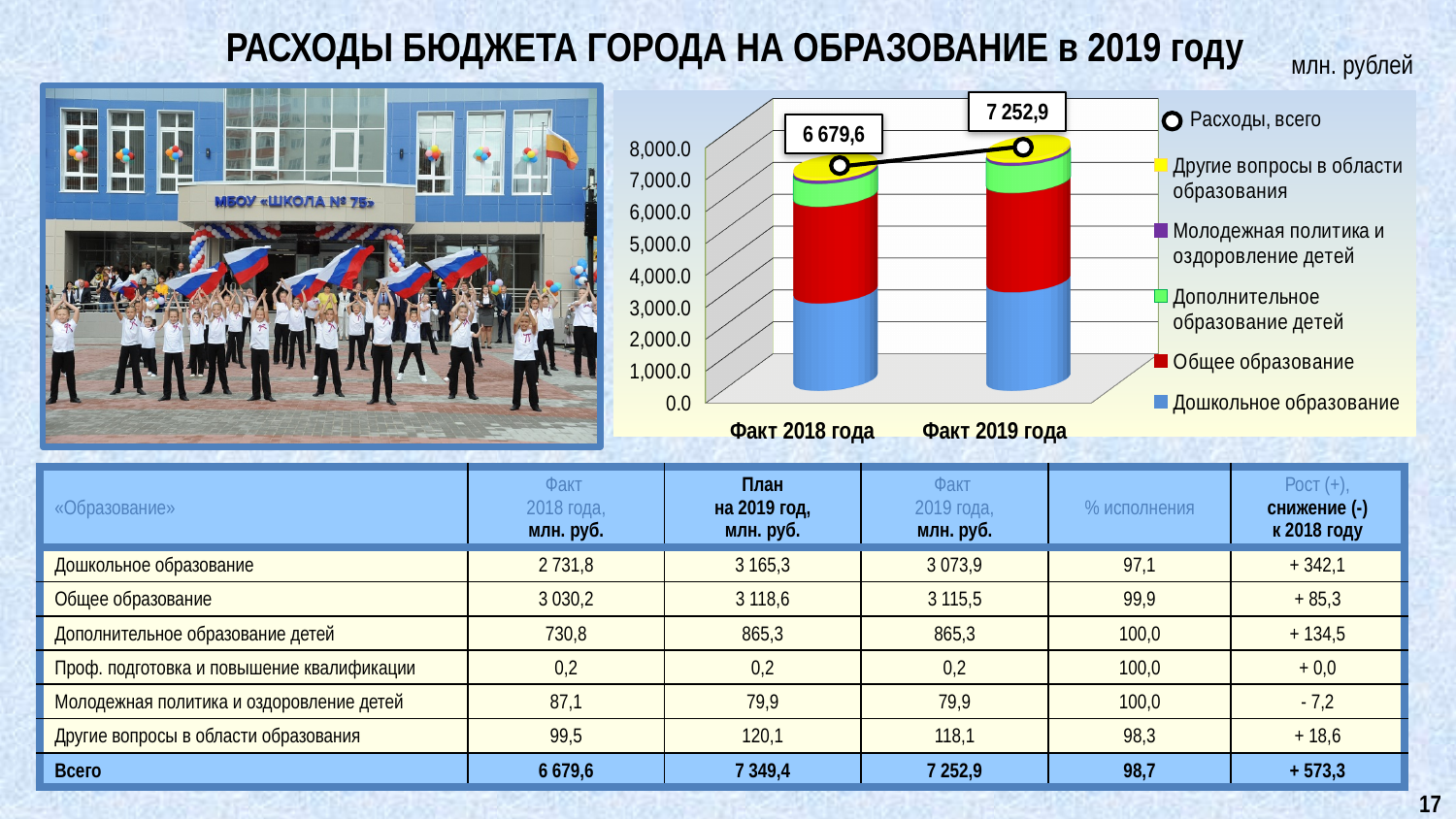
Which category has the higher value of «Расходы, всего»: «Факт 2018 года» or «Факт 2019 года»? Факт 2019 года What kind of chart is shown on the slide? stacked bar chart Is the «Дошкольное образование» segment for «Факт 2018 года» greater or less than 3,000.0? less What unit of measurement is indicated for the chart? млн. рублей How many categories are shown on the x axis of the chart? 2 By how much does «Расходы, всего» for «Факт 2019 года» exceed the value for «Факт 2018 года»? 573,3 How many entries does the chart legend list? 6 Is the total stacked bar for «Факт 2019 года» greater or less than 7,000.0? greater Which legend entry is shown in red on the chart? Общее образование What is the value of «Расходы, всего» for «Факт 2018 года»? 6 679,6 Does the value of «Расходы, всего» rise or fall from «Факт 2018 года» to «Факт 2019 года»? rise What is the value of «Расходы, всего» for «Факт 2019 года»? 7 252,9